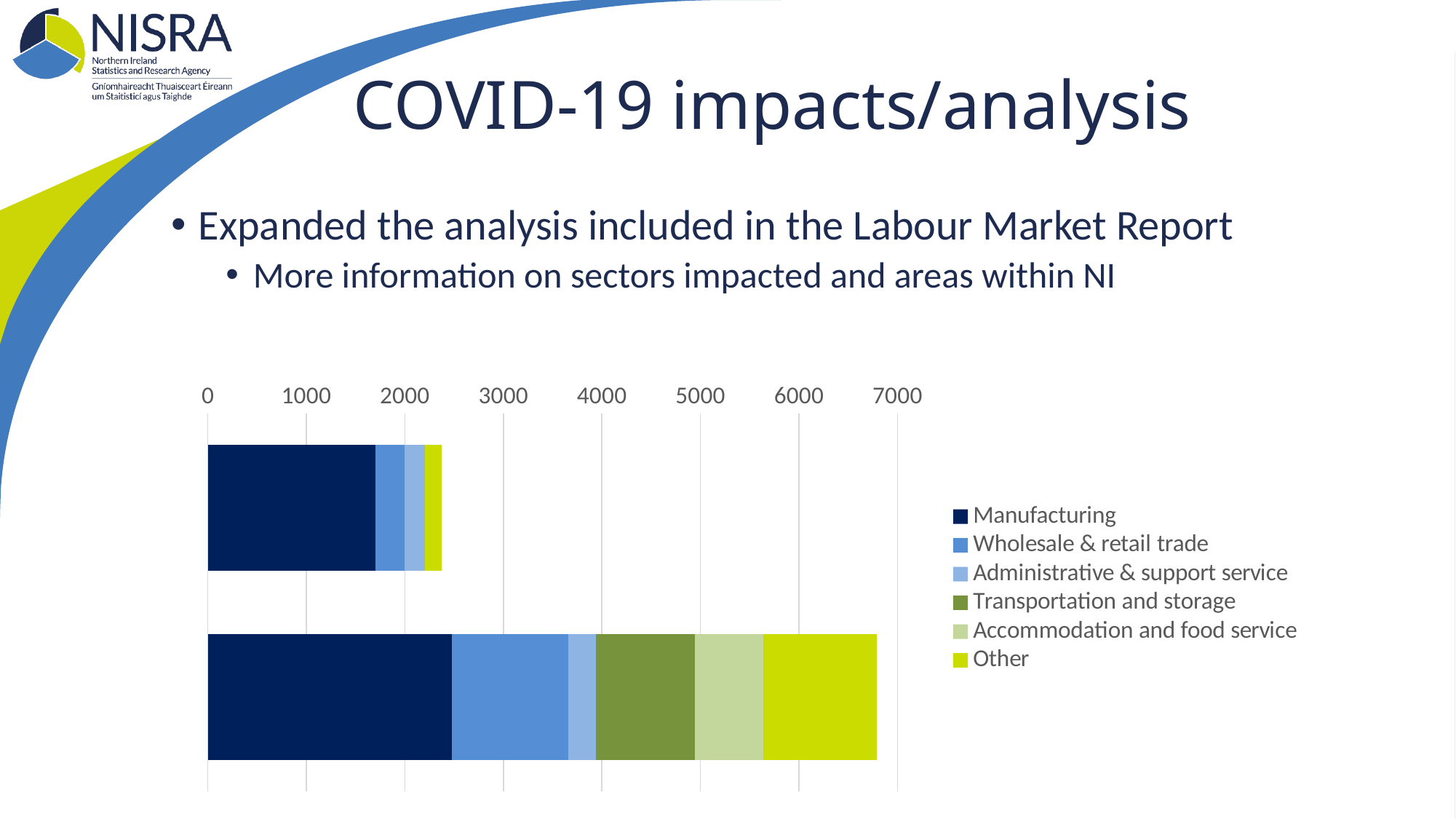
Is the Manufacturing segment of the top bar greater or less than 2000? less Is the total length of the bottom bar greater or less than 7000? less Which series is the largest segment in the bottom bar? Manufacturing Is the total length of the bottom bar greater or less than 6000? greater Which bar is longer in total, the top bar or the bottom bar? The bottom bar How many bars are plotted in the chart? 2 How many series does the chart's legend list? 6 What kind of chart is shown on the slide? Stacked bar chart What is the highest value shown on the chart's horizontal axis? 7000 Which series is listed first in the chart's legend? Manufacturing